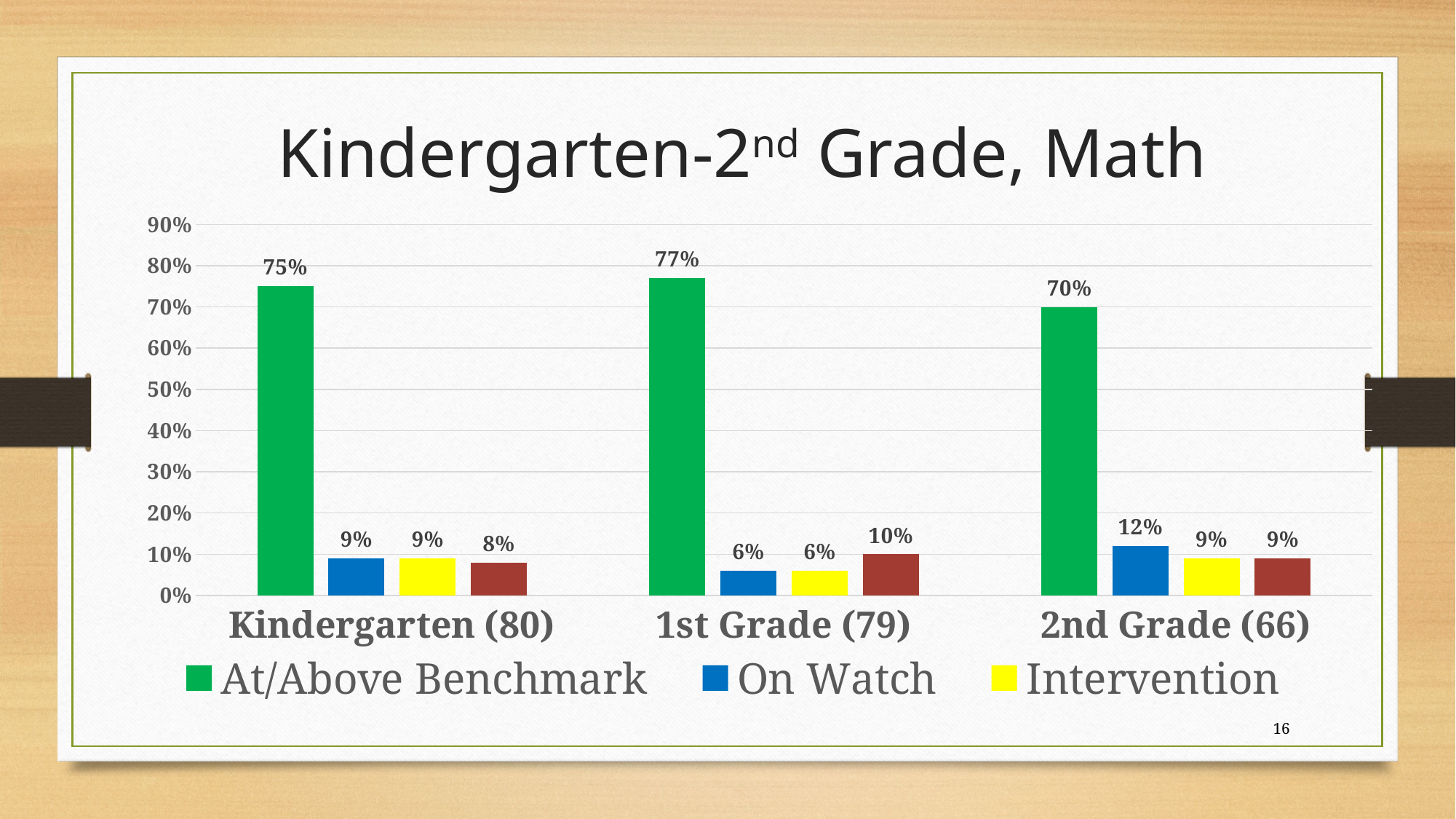
What is the On Watch value for 2nd Grade (66)? 12% Which grade has the highest At/Above Benchmark percentage? 1st Grade (79) Is the At/Above Benchmark value for 2nd Grade (66) greater or less than 60%? greater What type of chart is shown on the slide? Bar chart What is the At/Above Benchmark value for 1st Grade (79)? 77% Which grade has the lowest At/Above Benchmark percentage? 2nd Grade (66) How many grade-level categories are shown on the x axis? 3 How many series does the legend list? 3 What is the difference between the At/Above Benchmark values for 1st Grade and 2nd Grade? 7% Is the On Watch value larger for Kindergarten (80) or for 2nd Grade (66)? 2nd Grade (66) What is the Intervention value for 1st Grade (79)? 6% What percentage of Kindergarten students are At/Above Benchmark? 75%